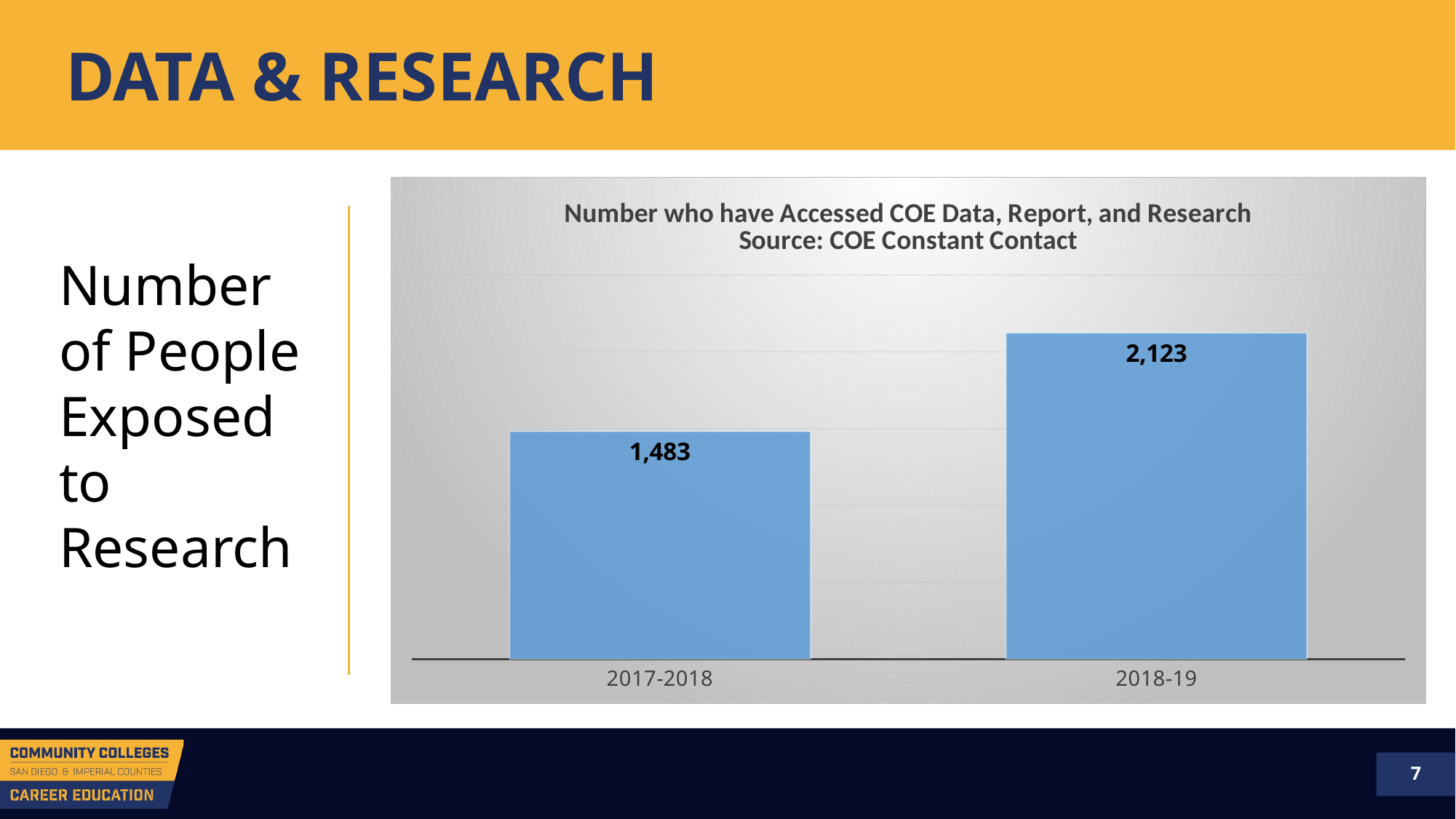
Which is larger, the value for 2017-2018 or the value for 2018-19? 2018-19 What kind of chart is shown on the slide? bar chart What is the value for 2017-2018? 1,483 What is the title of the chart? Number who have Accessed COE Data, Report, and Research What source is cited in the chart title? COE Constant Contact What is the value for 2018-19? 2,123 What is the difference between the values for 2018-19 and 2017-2018? 640 Which category has the lowest value? 2017-2018 How many categories are shown on the x axis? 2 Which category has the highest value? 2018-19 Do the values rise or fall from 2017-2018 to 2018-19? rise